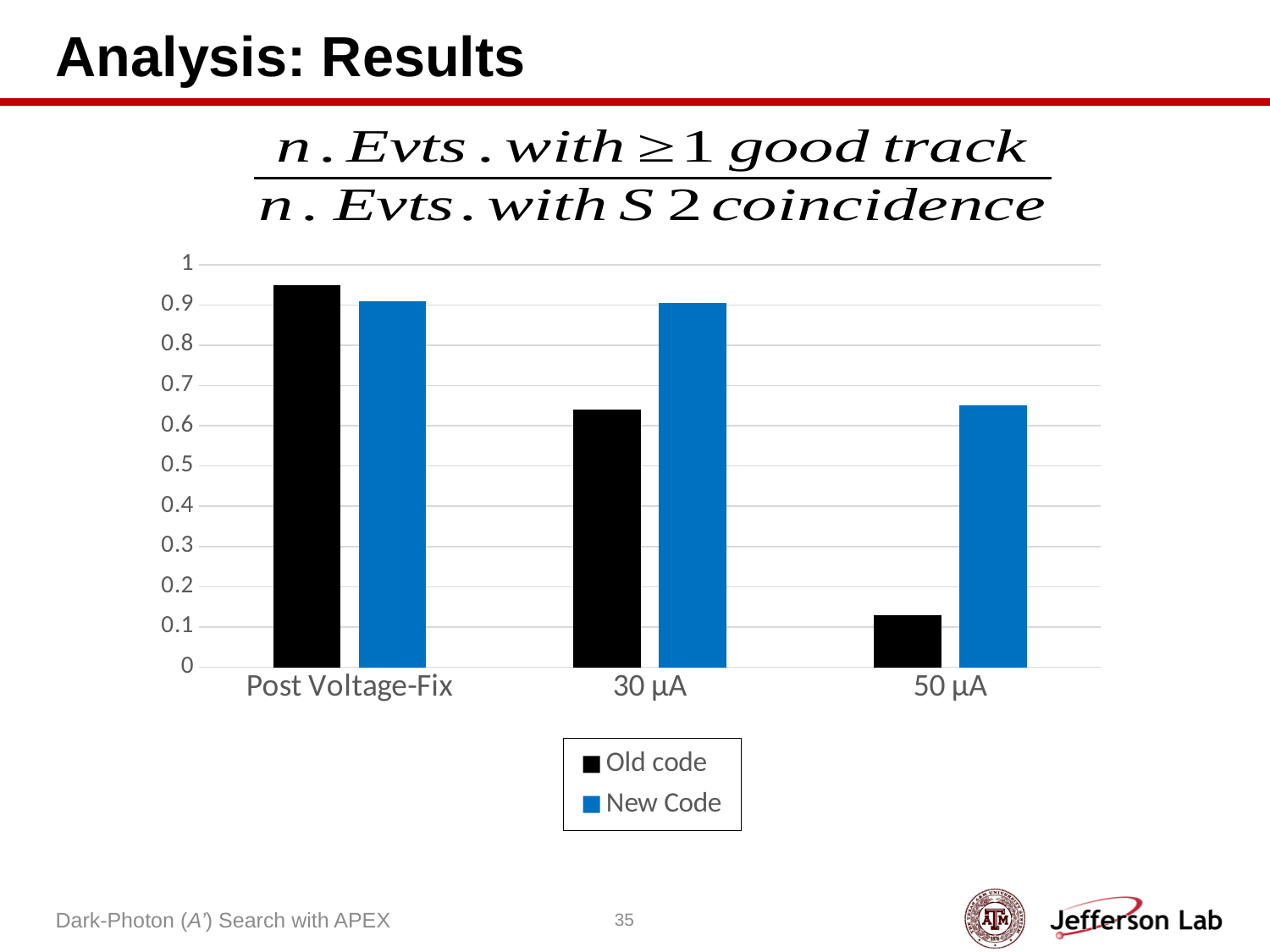
Is the New Code value for 30 µA greater or less than 0.8? greater Is the Old code value for 50 µA greater or less than 0.2? less At 50 µA, which series has the larger value, Old code or New Code? New Code Which category has the lowest New Code value? 50 µA Which category has the lowest Old code value? 50 µA What colour are the New Code bars? blue Which category has the highest Old code value? Post Voltage-Fix Is the Old code value for 30 µA greater or less than 0.7? less How many series does the legend list? 2 Do the Old code values rise or fall from Post Voltage-Fix to 50 µA? fall What kind of chart is shown on the slide? bar chart How many categories are shown on the x axis? 3